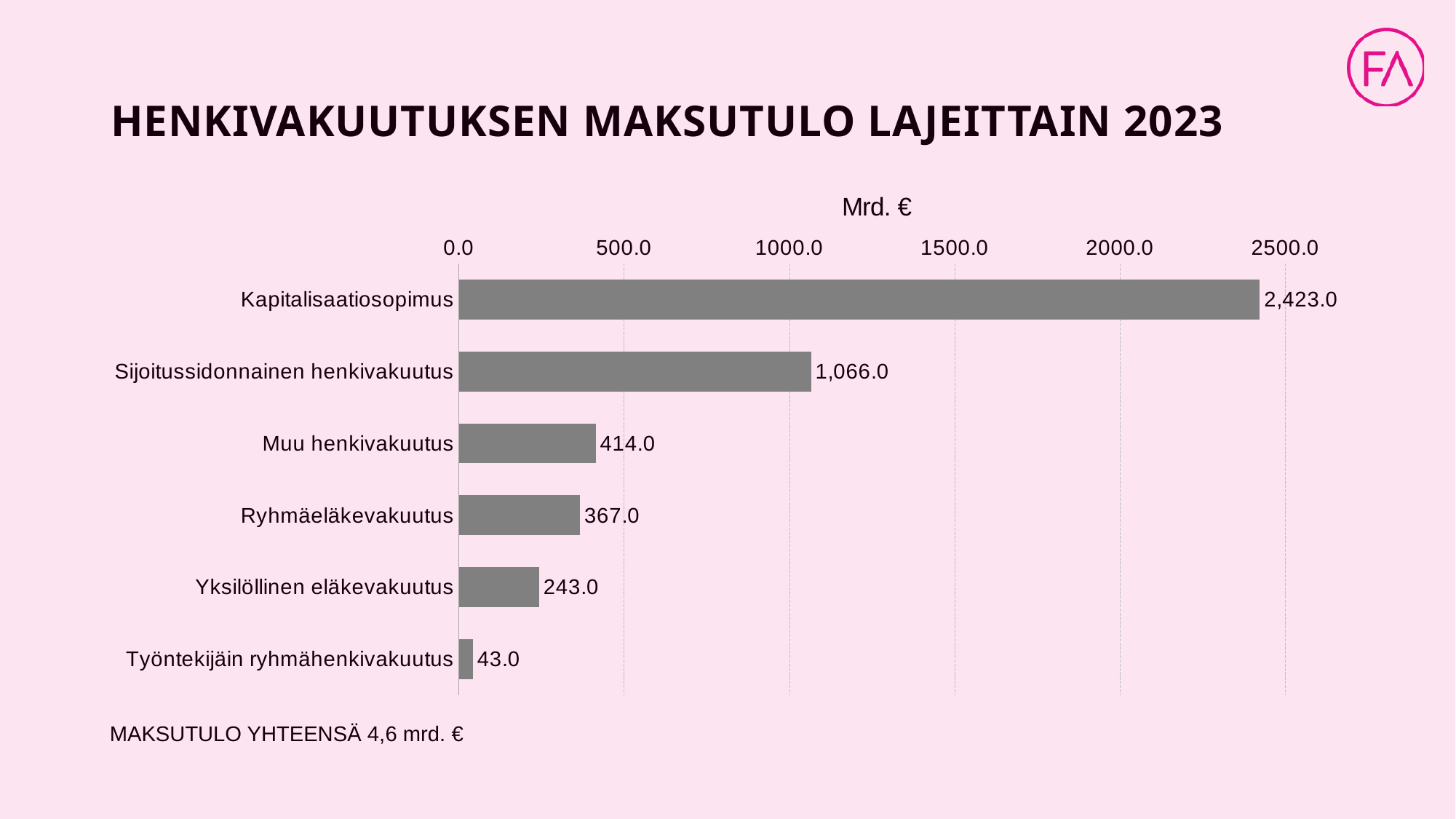
Which category has the highest value? Kapitalisaatiosopimus What is the difference between the values for Muu henkivakuutus and Ryhmäeläkevakuutus? 47.0 How many categories are shown in the chart? 6 What kind of chart is shown on the slide? bar chart Is the value for Sijoitussidonnainen henkivakuutus greater or less than 1000.0? greater What is the value for Sijoitussidonnainen henkivakuutus? 1,066.0 What is the difference between the values for Kapitalisaatiosopimus and Sijoitussidonnainen henkivakuutus? 1,357.0 What is the value for Työntekijäin ryhmähenkivakuutus? 43.0 What is the value for Kapitalisaatiosopimus? 2,423.0 What unit is shown above the chart's value axis? Mrd. € Which is larger, the value for Yksilöllinen eläkevakuutus or the value for Ryhmäeläkevakuutus? Ryhmäeläkevakuutus Which category has the lowest value? Työntekijäin ryhmähenkivakuutus